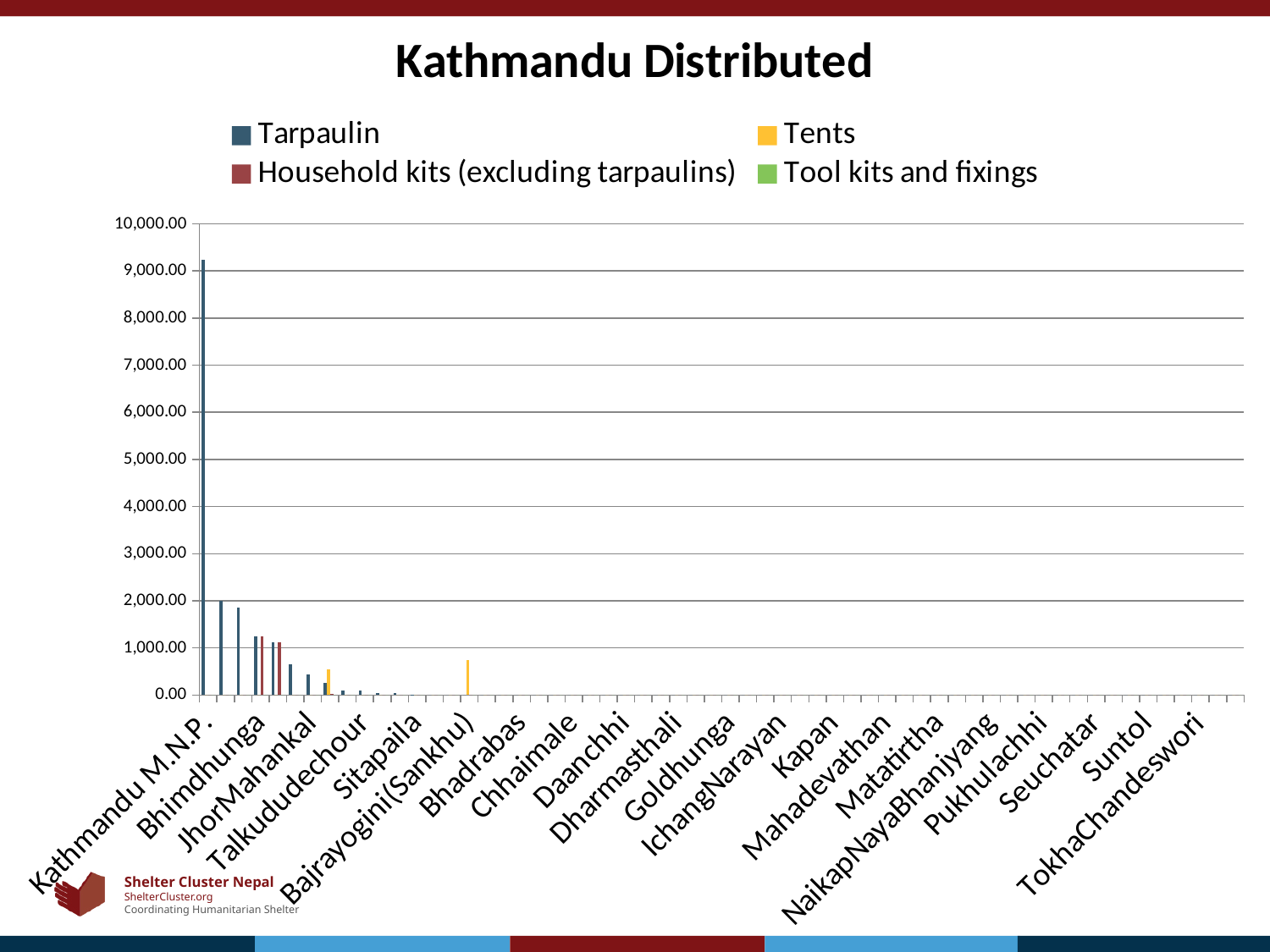
Which has the larger Tarpaulin value, Kathmandu M.N.P. or Bhimdhunga? Kathmandu M.N.P. Which category has the tallest bar in the chart? Kathmandu M.N.P. What is the title of the chart? Kathmandu Distributed Is the Tarpaulin value for Kathmandu M.N.P. greater or less than 5,000? greater Is the Tarpaulin value for Kathmandu M.N.P. greater or less than 8,000? greater What type of chart is shown on the slide? Bar chart Which series is shown in yellow in the legend? Tents Which series has the single highest bar in the chart? Tarpaulin Is the Tarpaulin value for Kathmandu M.N.P. greater or less than 10,000? less How many series does the legend list? 4